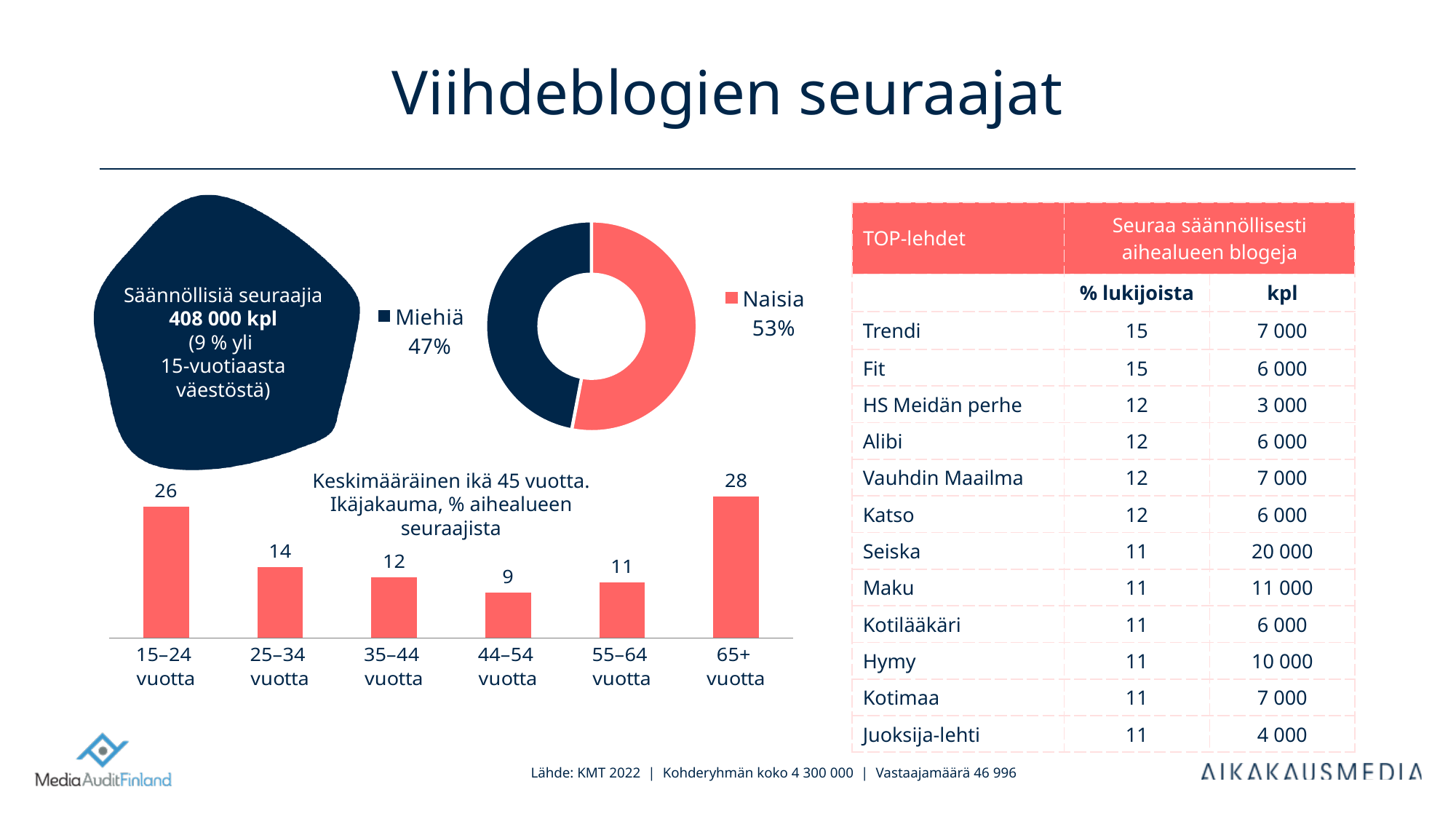
How many series does the legend of the donut chart list? 2 In the donut chart, what share is Naisia? 53% In the donut chart, which is larger: Miehiä or Naisia? Naisia In the age distribution bar chart, which age group has the highest value? 65+ vuotta In the age distribution bar chart, what is the value for 15–24 vuotta? 26 In the age distribution bar chart, what is the difference between the values for 65+ vuotta and 15–24 vuotta? 2 What kind of chart is used to show the age distribution? bar chart In the age distribution bar chart, which is larger: the value for 25–34 vuotta or 55–64 vuotta? 25–34 vuotta In the donut chart, what share is Miehiä? 47% In the age distribution bar chart, which age group has the lowest value? 44–54 vuotta In the age distribution bar chart, what is the value for 44–54 vuotta? 9 How many age groups are shown in the age distribution bar chart? 6